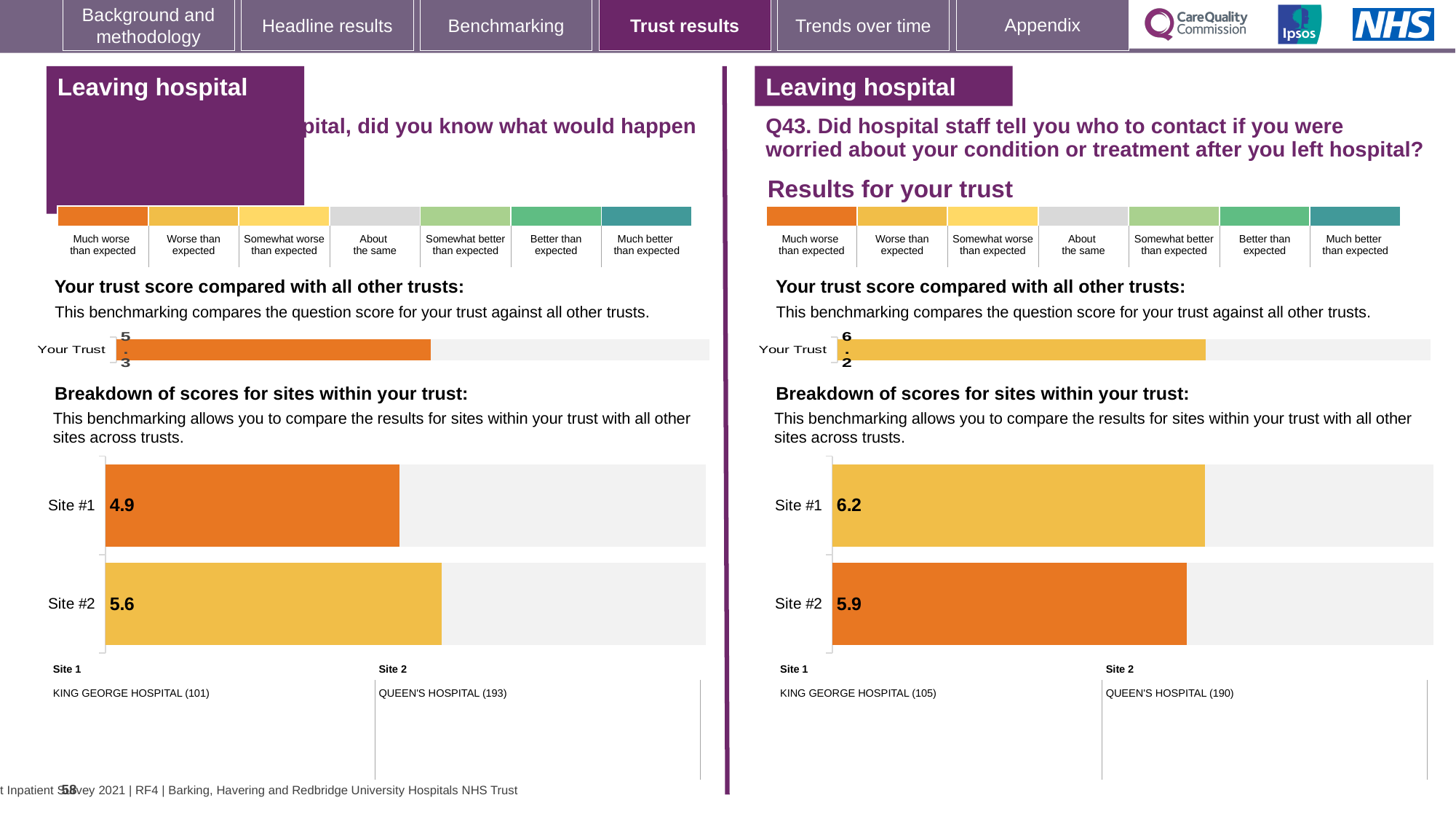
What type of chart is used for the site breakdown on the left half of the slide? Bar chart On the right half of the slide (Q43), in the site breakdown chart, how many sites are shown? 2 On the right half of the slide (Q43), in the 'Your trust score compared with all other trusts' chart, what is the score for Your Trust? 6.2 On the right half of the slide (Q43), in the 'Breakdown of scores for sites within your trust' chart, what is the score for Site #2? 5.9 On the left half of the slide, in the 'Your trust score compared with all other trusts' chart, what is the score for Your Trust? 5.3 On the right half of the slide (Q43), in the site breakdown chart, which site has the lower score? Site #2 On the right half of the slide (Q43), in the site breakdown chart, what is the difference between the scores for Site #1 and Site #2? 0.3 On the left half of the slide, in the site breakdown chart, which site has the higher score? Site #2 On the right half of the slide (Q43), in the site breakdown chart, what colour is the bar for Site #2? Orange On the left half of the slide, in the 'Breakdown of scores for sites within your trust' chart, what is the score for Site #1? 4.9 On the left half of the slide, in the 'Breakdown of scores for sites within your trust' chart, what is the score for Site #2? 5.6 On the left half of the slide, in the site breakdown chart, what is the difference between the scores for Site #2 and Site #1? 0.7